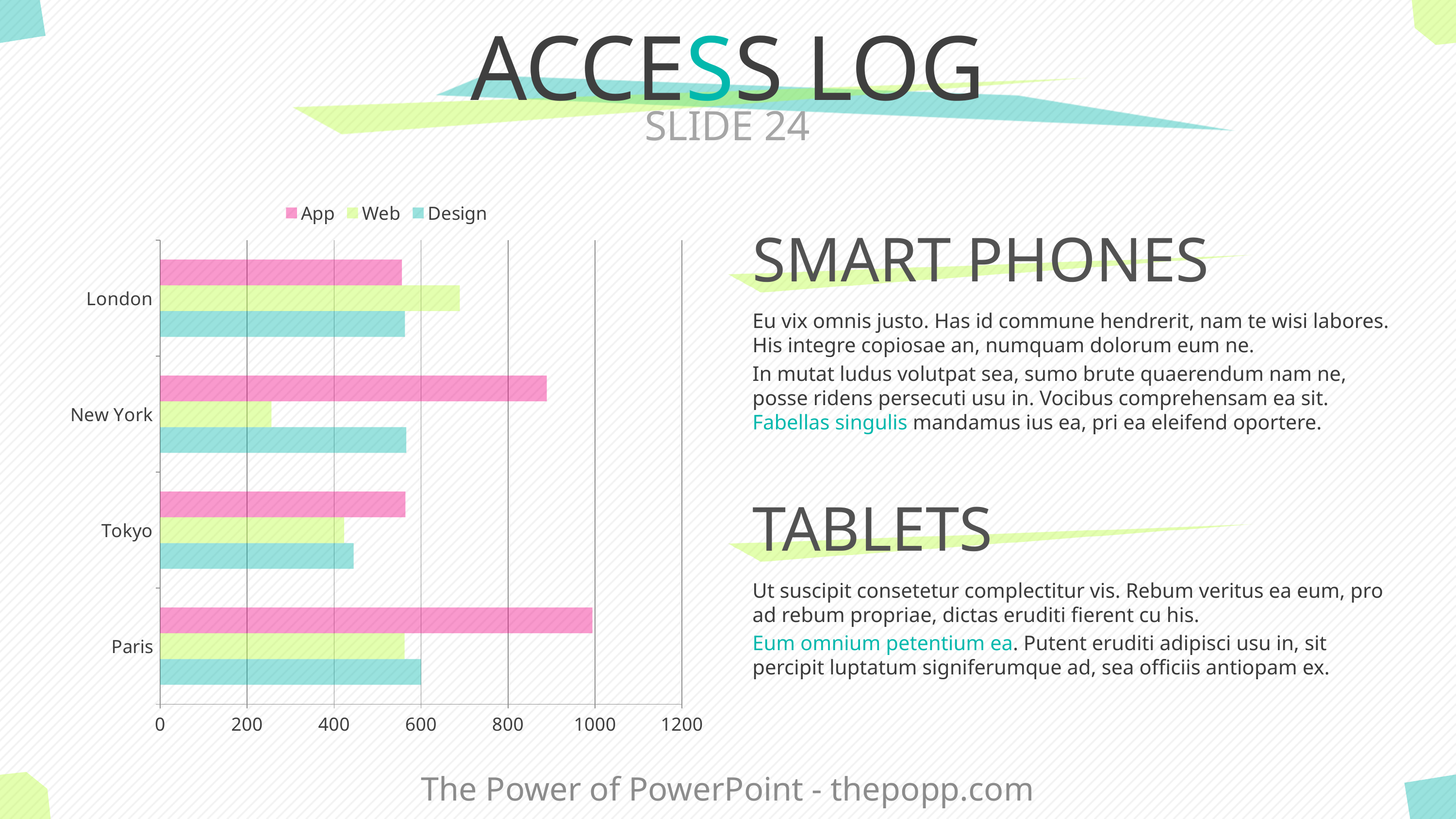
How many series does the chart legend list? 3 Which city has the lowest Web value? New York Which series is shown in pink in the legend? App What kind of chart is shown on the slide? bar chart Which city has the highest Web value? London Is the Web value for London greater or less than 600? greater Which city has the highest App value? Paris How many categories (cities) are shown on the chart? 4 For New York, which is larger: the App value or the Web value? App Is the Web value for New York greater or less than 400? less Is the App value for New York greater or less than 800? greater